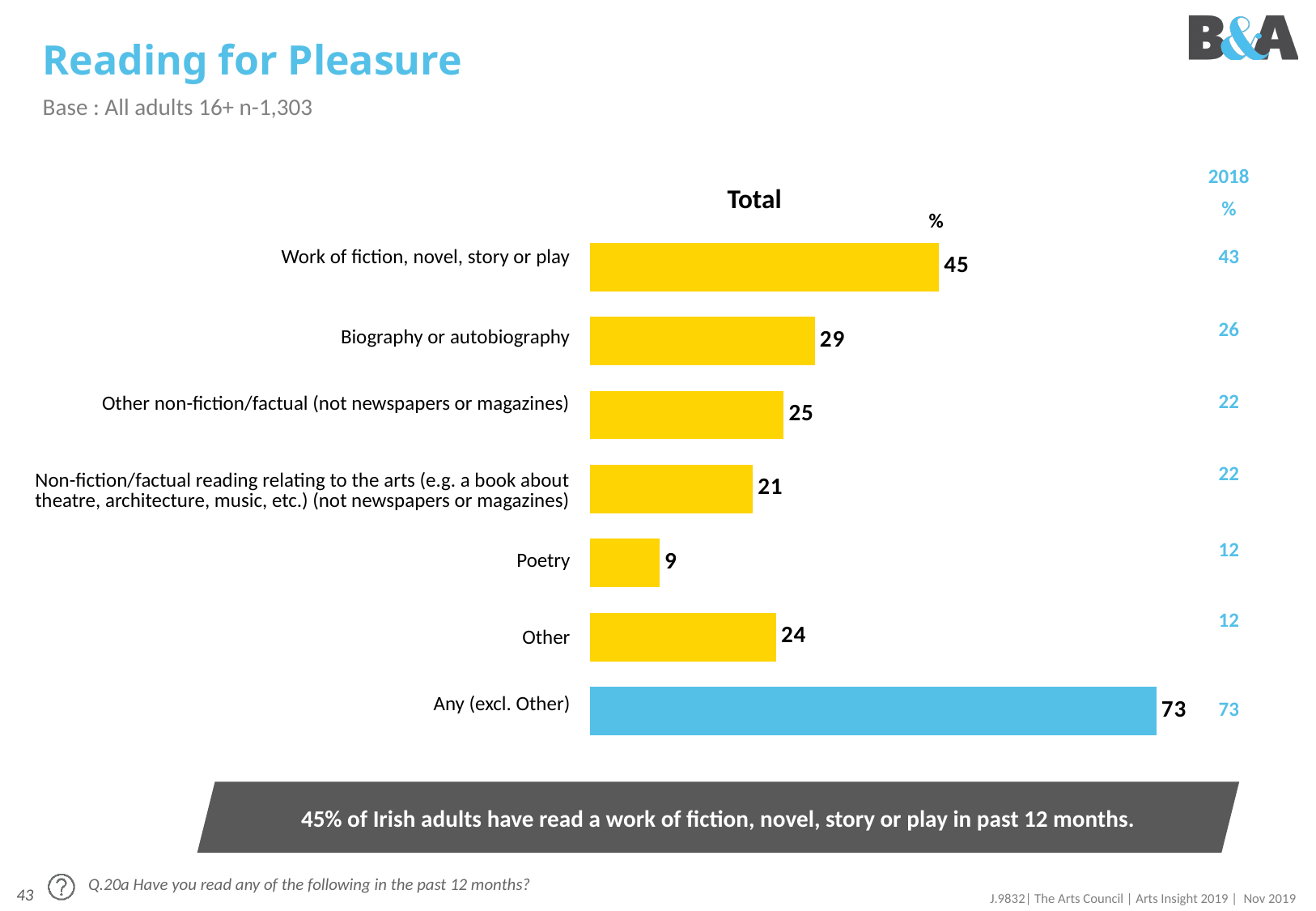
How many categories are shown in the chart? 7 What was the 2018 value for Work of fiction, novel, story or play shown in the column on the right? 43 Which category has the highest value? Any (excl. Other) Which category has the lowest value? Poetry What colour is the bar for Any (excl. Other)? Blue Which is larger, the value for Other or the value for Poetry? Other What is the value for Any (excl. Other)? 73 What kind of chart is shown on the slide? Bar chart What is the difference between the values for Biography or autobiography and Other non-fiction/factual (not newspapers or magazines)? 4 What is the value for Poetry? 9 What is the value for Biography or autobiography? 29 What is the value for Work of fiction, novel, story or play? 45